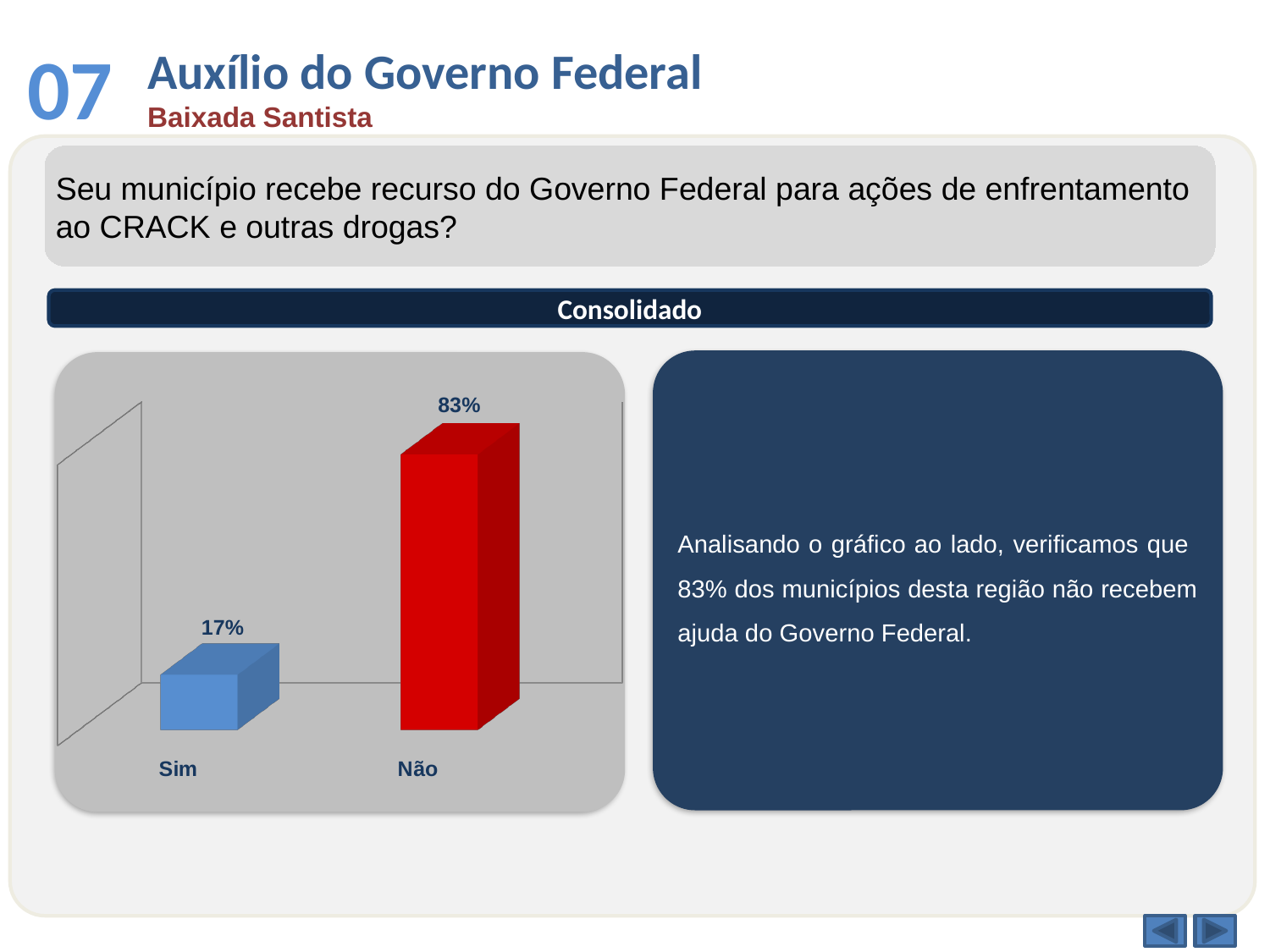
Which category has the lowest value? Sim What kind of chart is shown on the slide? Bar chart Which is larger, the value for "Sim" or the value for "Não"? Não What is the value for "Não"? 83% What colour is the bar for "Não"? Red What is the value for "Sim"? 17% What is the difference between the values for "Não" and "Sim"? 66% How many categories are shown in the chart? 2 What is the total of the two values shown in the chart? 100% Which category has the highest value? Não What colour is the bar for "Sim"? Blue